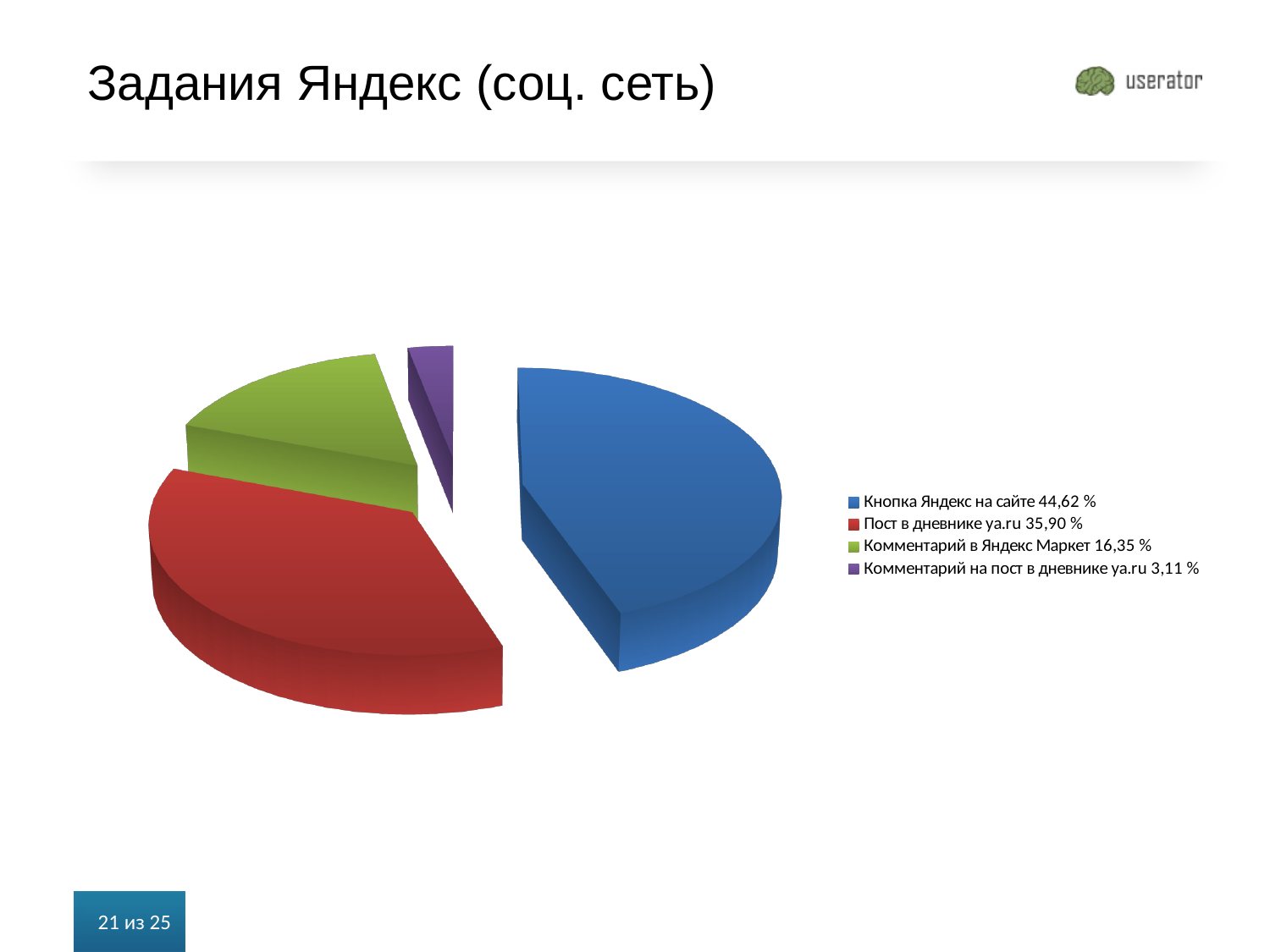
What is the share for "Кнопка Яндекс на сайте"? 44,62 % What kind of chart is shown on the slide? Pie chart What colour is the slice for "Пост в дневнике ya.ru"? Red Which category has the largest slice of the pie? Кнопка Яндекс на сайте What is the share for "Комментарий в Яндекс Маркет"? 16,35 % What is the share for "Комментарий на пост в дневнике ya.ru"? 3,11 % What is the share for "Пост в дневнике ya.ru"? 35,90 % What is the difference between the shares of "Кнопка Яндекс на сайте" and "Пост в дневнике ya.ru"? 8,72 % What is the difference between the shares of "Пост в дневнике ya.ru" and "Комментарий в Яндекс Маркет"? 19,55 % Which is larger: the share of "Комментарий в Яндекс Маркет" or "Комментарий на пост в дневнике ya.ru"? Комментарий в Яндекс Маркет How many categories does the pie chart show? 4 Which category has the smallest slice of the pie? Комментарий на пост в дневнике ya.ru